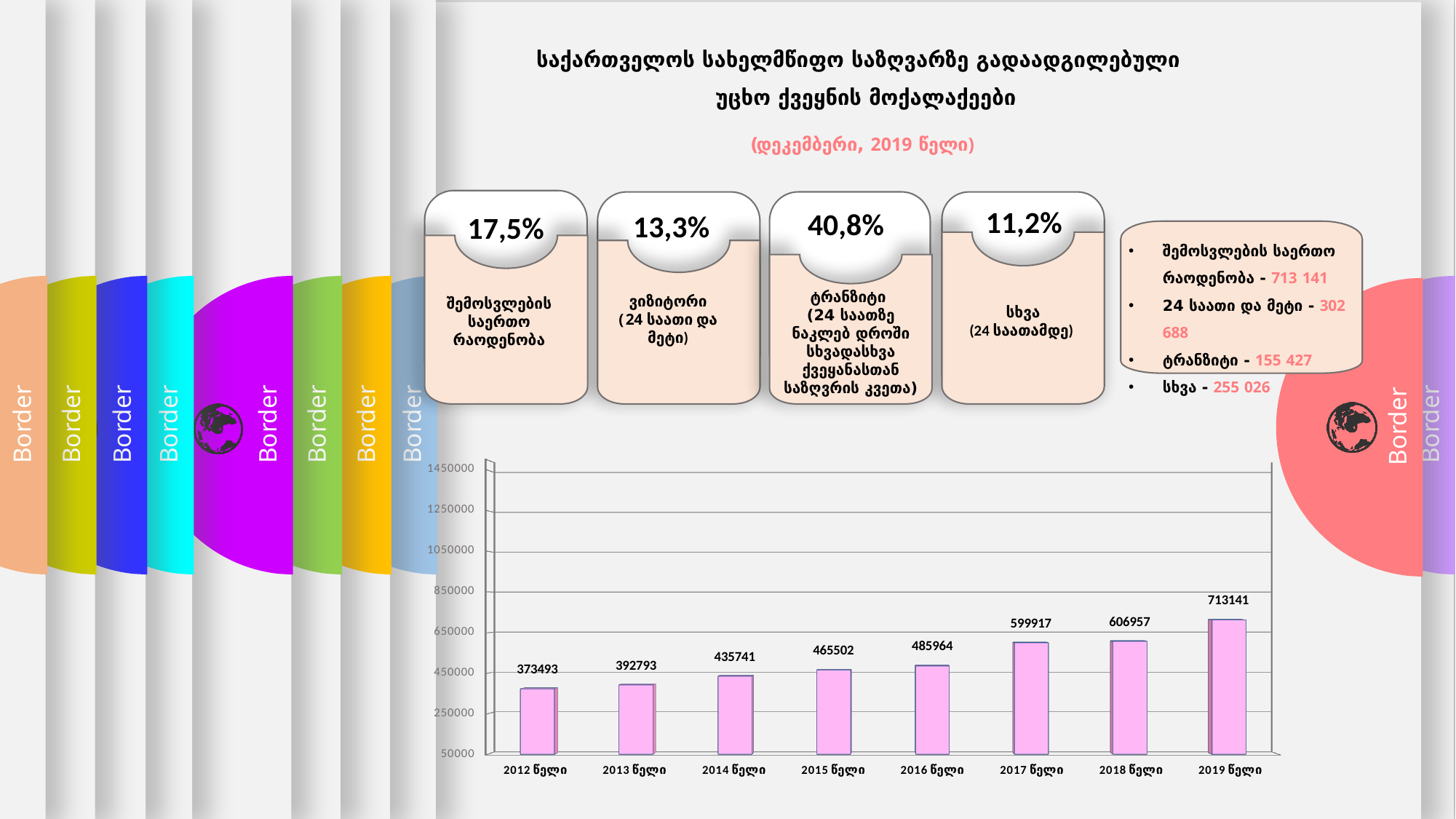
What kind of chart is shown at the bottom of the slide? bar chart What is the difference between the values for 2016 and 2015 in the bar chart? 20462 How many years are shown in the bar chart? 8 What is the value for 2019 in the bar chart? 713141 What is the difference between the values for 2019 and 2018 in the bar chart? 106184 What is the value for 2017 in the bar chart? 599917 Do the values in the bar chart rise or fall from 2012 to 2019? rise Which is larger in the bar chart, the value for 2014 or the value for 2016? 2016 Is the value for 2017 in the bar chart greater or less than 650000? less Which year has the highest value in the bar chart? 2019 What is the value for 2012 in the bar chart? 373493 Which year has the lowest value in the bar chart? 2012